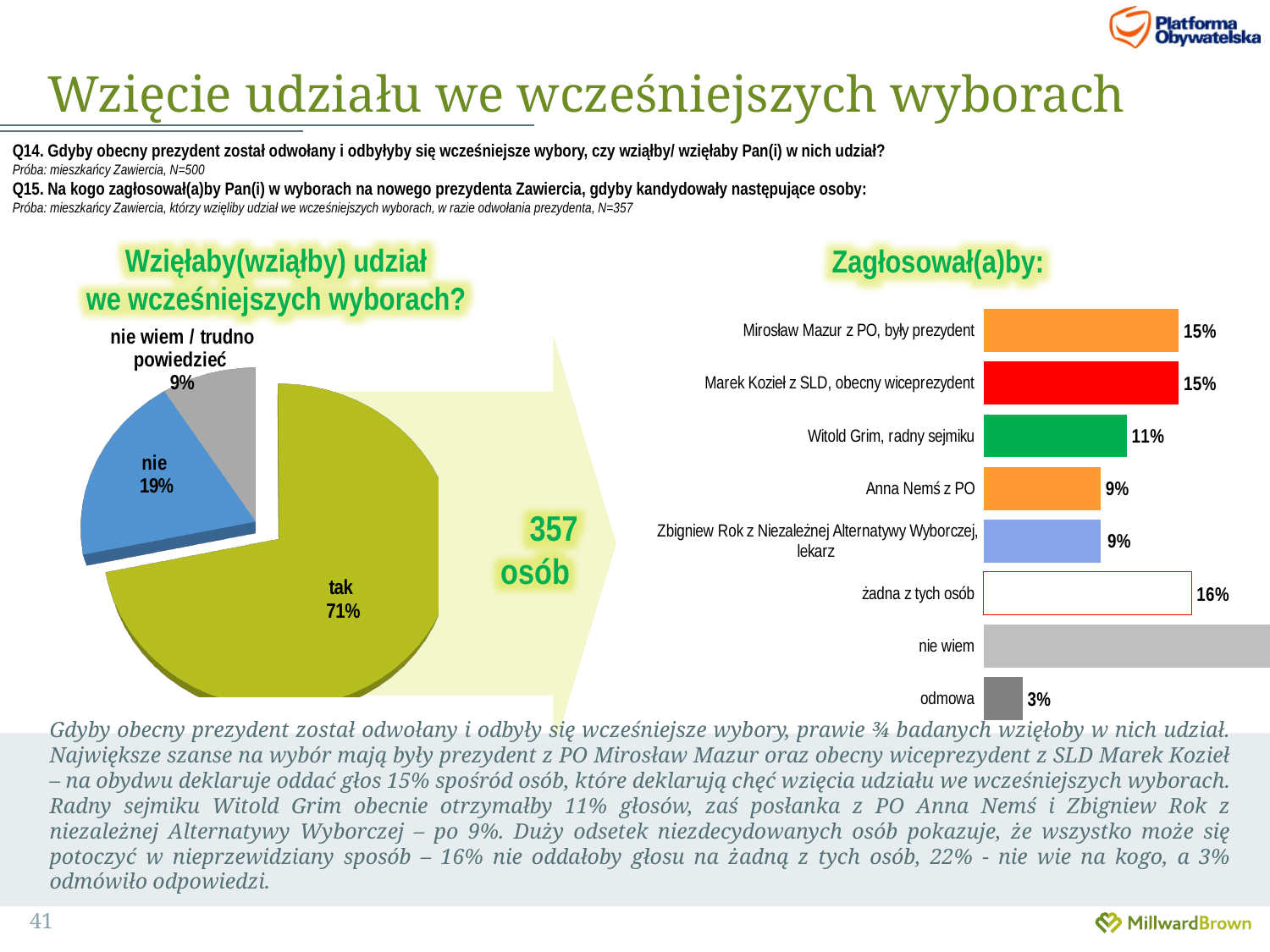
In the pie chart on the left, which answer has the largest slice? tak In the bar chart "Zagłosował(a)by:", what is the value for "żadna z tych osób"? 16% What kind of chart is the one on the right titled "Zagłosował(a)by:"? bar chart In the pie chart on the left, what share of respondents answered "tak"? 71% In the pie chart on the left, what share of respondents answered "nie"? 19% What kind of chart is the one on the left titled "Wzięłaby(wziąłby) udział we wcześniejszych wyborach?"? pie chart In the bar chart "Zagłosował(a)by:", what is the value for "odmowa"? 3% In the bar chart "Zagłosował(a)by:", what is the difference between the values for Mirosław Mazur z PO and Anna Nemś z PO? 6% In the bar chart "Zagłosował(a)by:", what is the value for Witold Grim, radny sejmiku? 11% In the pie chart on the left, what is the value for "nie wiem / trudno powiedzieć"? 9% In the pie chart on the left, how many slices are there? 3 In the bar chart "Zagłosował(a)by:", how many categories are shown? 8